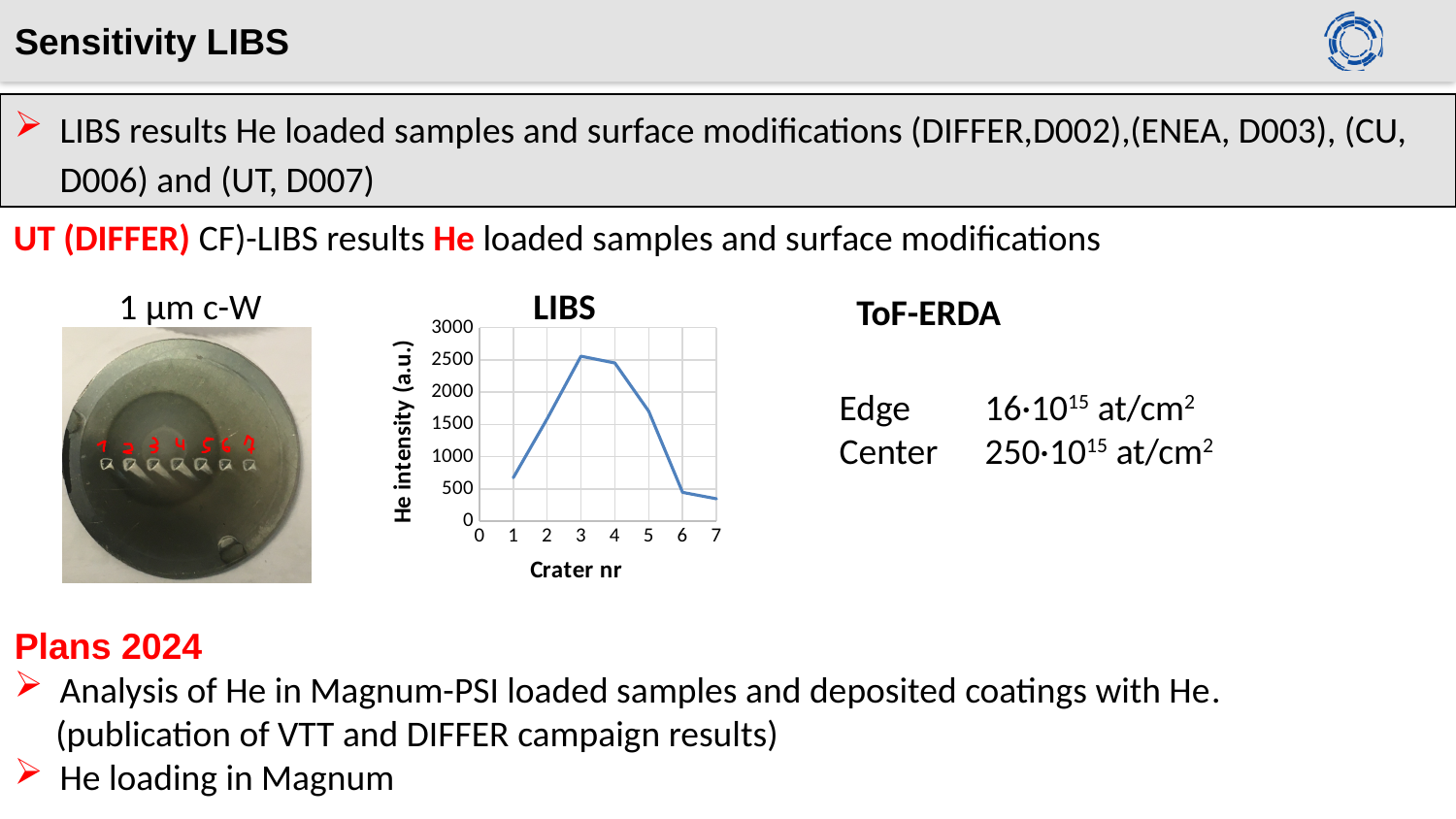
Is the He intensity for crater 5 greater or less than 1500? greater At which crater number is the He intensity highest on the LIBS chart? 3 Is the He intensity for crater 1 greater or less than 1000? less What kind of chart is the LIBS chart? line chart Is the He intensity for crater 6 greater or less than 1000? less Which has the higher He intensity on the LIBS chart, crater 2 or crater 6? crater 2 How many crater data points are plotted on the LIBS chart? 7 How does the He intensity change from crater 3 to crater 7 on the LIBS chart? it falls What is the label of the x axis on the LIBS chart? Crater nr At which crater number is the He intensity lowest on the LIBS chart? 7